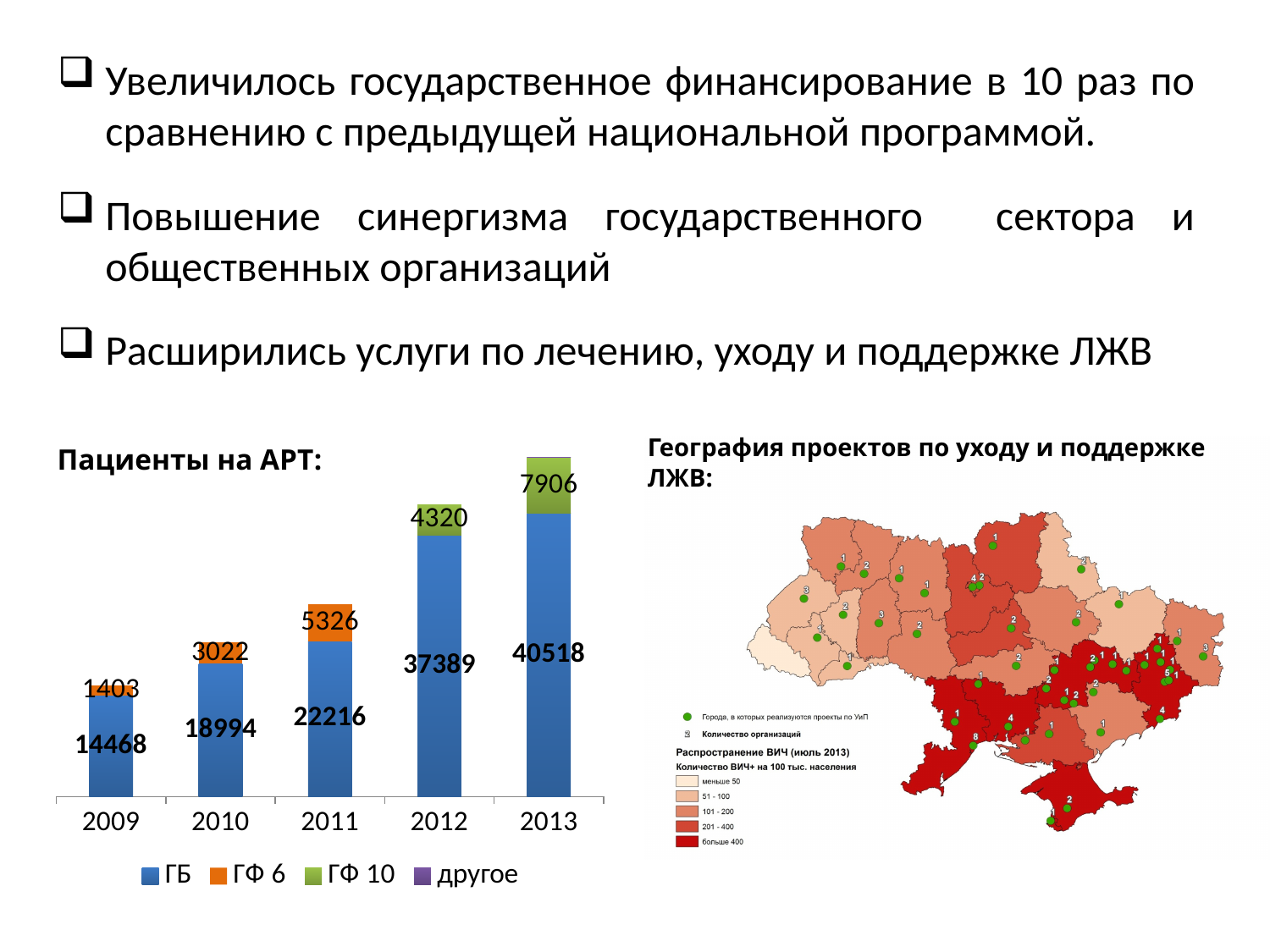
In the chart 'Пациенты на АРТ:', how many series does the legend list? 4 What kind of chart is 'Пациенты на АРТ:'? Stacked bar chart In the chart 'Пациенты на АРТ:', what is the difference between the ГБ values for 2013 and 2012? 3129 In the chart 'Пациенты на АРТ:', what is the difference between the ГФ 10 values for 2013 and 2012? 3586 In the chart 'Пациенты на АРТ:', what is the value of ГФ 10 for 2012? 4320 In the chart 'Пациенты на АРТ:', how many years are shown on the x axis? 5 In the chart 'Пациенты на АРТ:', which year has the lowest ГБ value? 2009 In the chart 'Пациенты на АРТ:', which year has the highest ГБ value? 2013 In the chart 'Пациенты на АРТ:', what is the value of ГБ for 2009? 14468 In the chart 'Пациенты на АРТ:', what is the value of ГБ for 2013? 40518 In the chart 'Пациенты на АРТ:', what is the value of ГФ 6 for 2011? 5326 In the chart 'Пациенты на АРТ:', is the ГБ value for 2012 larger than the ГБ value for 2011? Yes